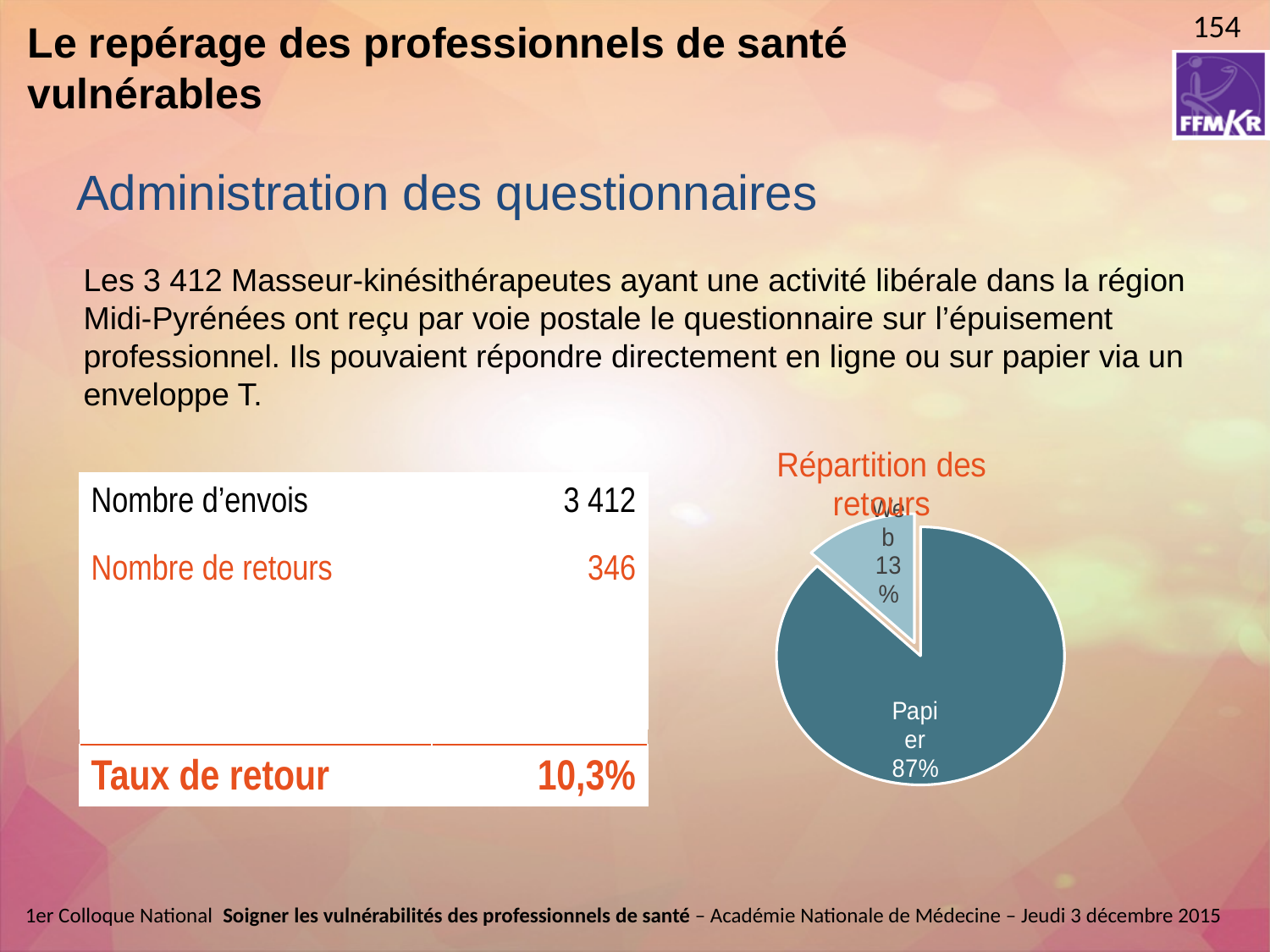
How many slices does the pie chart have? 2 What do the two slices of the pie chart add up to? 100% Which is larger in the pie chart, Papier or Web? Papier What kind of chart is shown on the slide? pie chart What share of the pie chart is Papier? 87% Which slice of the pie chart is the largest? Papier What share of the pie chart is Web? 13% What is the title of the pie chart? Répartition des retours Which slice of the pie chart is the smallest? Web What is the difference in percentage points between the Papier and Web slices? 74 Is the Papier share of the pie chart greater or less than 50%? greater